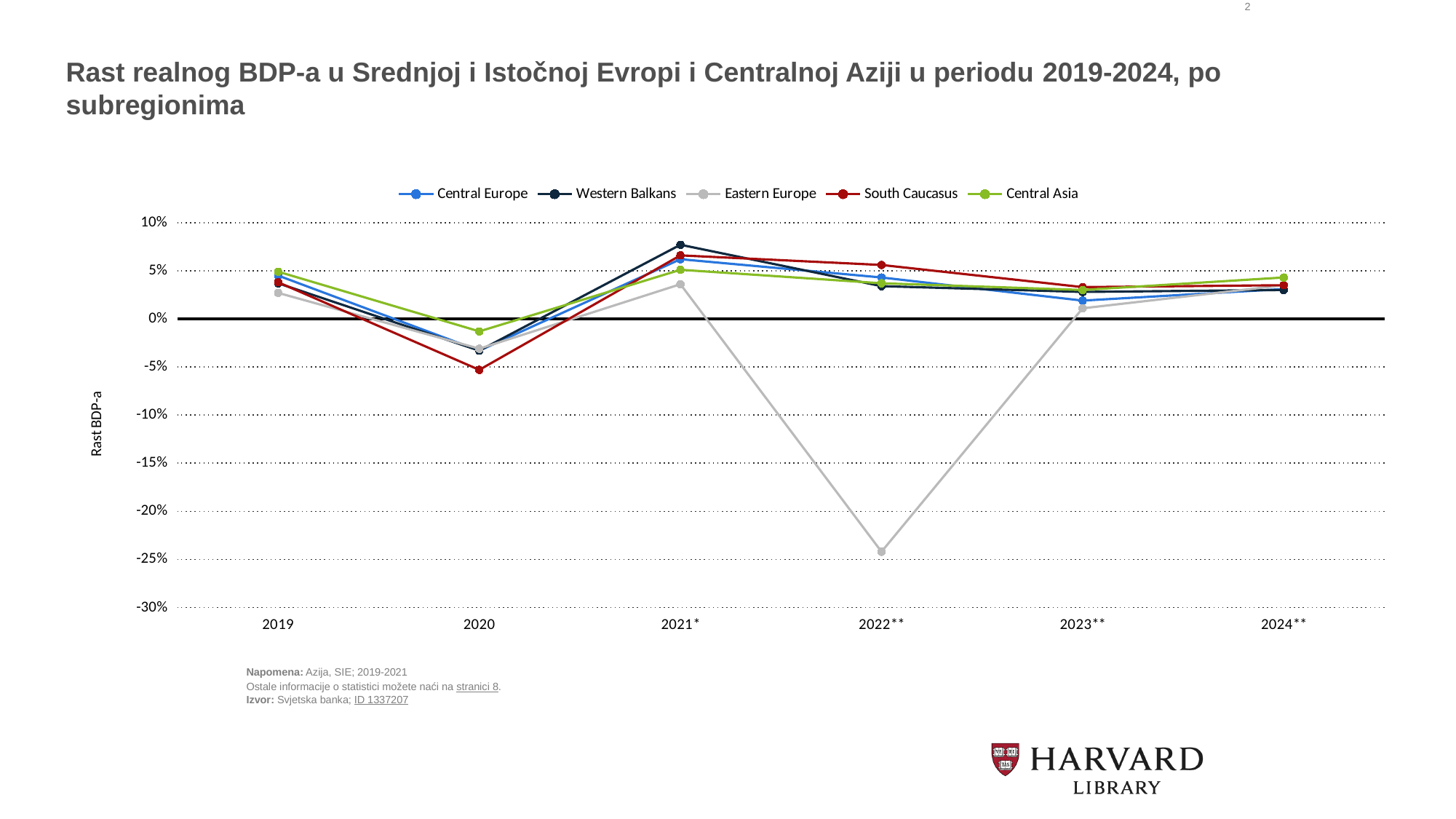
Which series has the lowest value in 2020? South Caucasus Which series has the lowest value in 2022**? Eastern Europe Is the value for Eastern Europe in 2022** greater or less than -20%? less How many years are shown along the x axis? 6 Does the Eastern Europe line rise or fall from 2021* to 2022**? fall Which series has the highest value in 2021*? Western Balkans How many series does the legend list? 5 What is the label on the y axis? Rast BDP-a What kind of chart is shown on the slide? Line chart Which series has the highest value in 2020? Central Asia Which is larger in 2022**: the value for South Caucasus or the value for Western Balkans? South Caucasus Is the value for Western Balkans in 2021* greater or less than 5%? greater